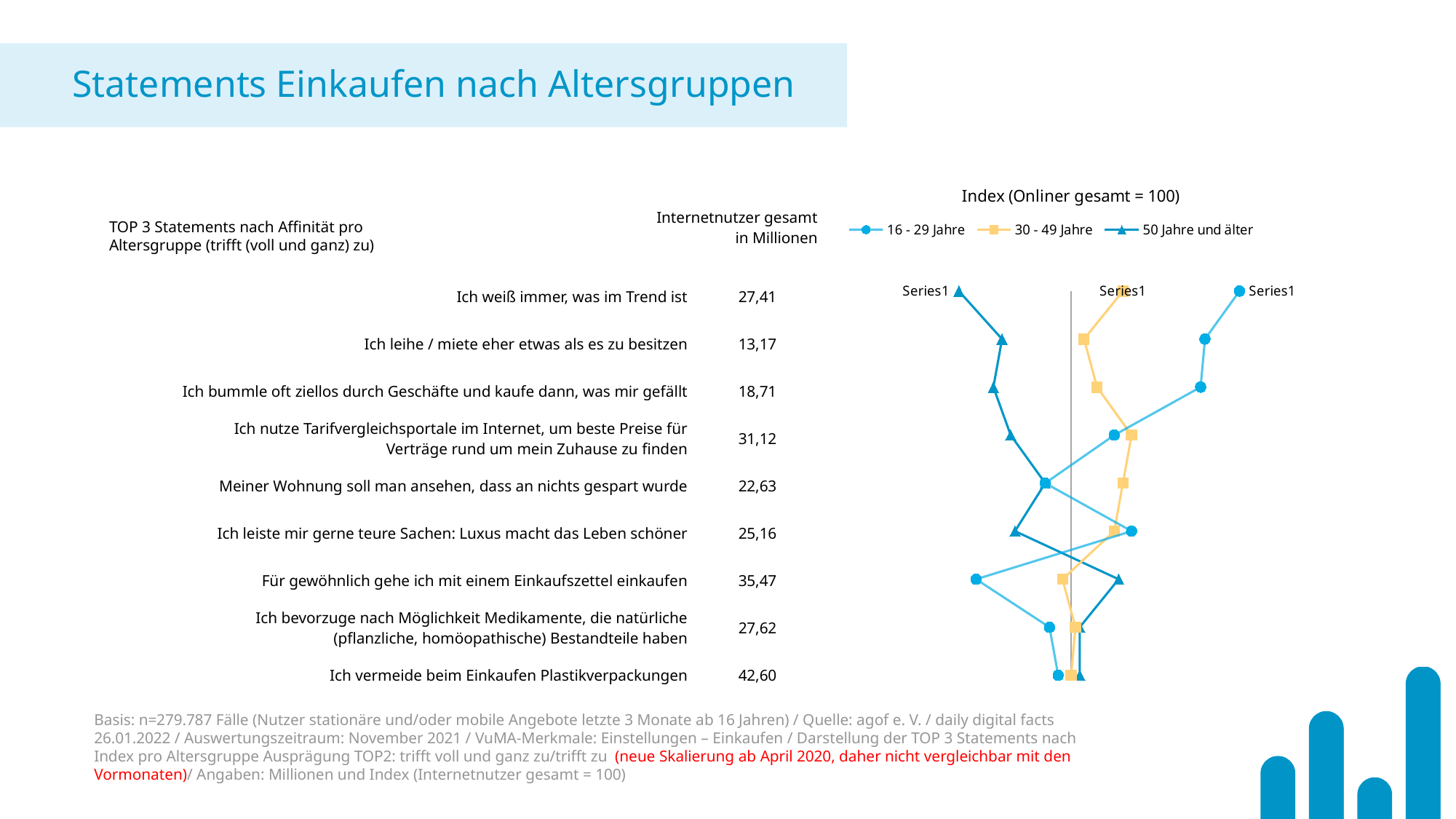
Is the index for 16 - 29 Jahre for 'Für gewöhnlich gehe ich mit einem Einkaufszettel einkaufen' greater or less than 100? less What reference value does the vertical line in the chart represent, according to the chart heading? Index (Onliner gesamt = 100) What kind of chart is shown on the slide? line chart Is the index for 16 - 29 Jahre for 'Ich weiß immer, was im Trend ist' greater or less than 100? greater For which statement does the 50 Jahre und älter series reach its highest index? Für gewöhnlich gehe ich mit einem Einkaufszettel einkaufen For which statement does the 16 - 29 Jahre series reach its highest index? Ich weiß immer, was im Trend ist For which statement does the 50 Jahre und älter series reach its lowest index? Ich weiß immer, was im Trend ist How many statements (categories) are plotted in the chart? 9 How many series does the chart legend list? 3 Which age groups are listed in the chart legend? 16 - 29 Jahre, 30 - 49 Jahre, 50 Jahre und älter For 'Ich weiß immer, was im Trend ist', which series has the larger index: 16 - 29 Jahre or 50 Jahre und älter? 16 - 29 Jahre Is the index for 50 Jahre und älter for 'Ich weiß immer, was im Trend ist' greater or less than 100? less